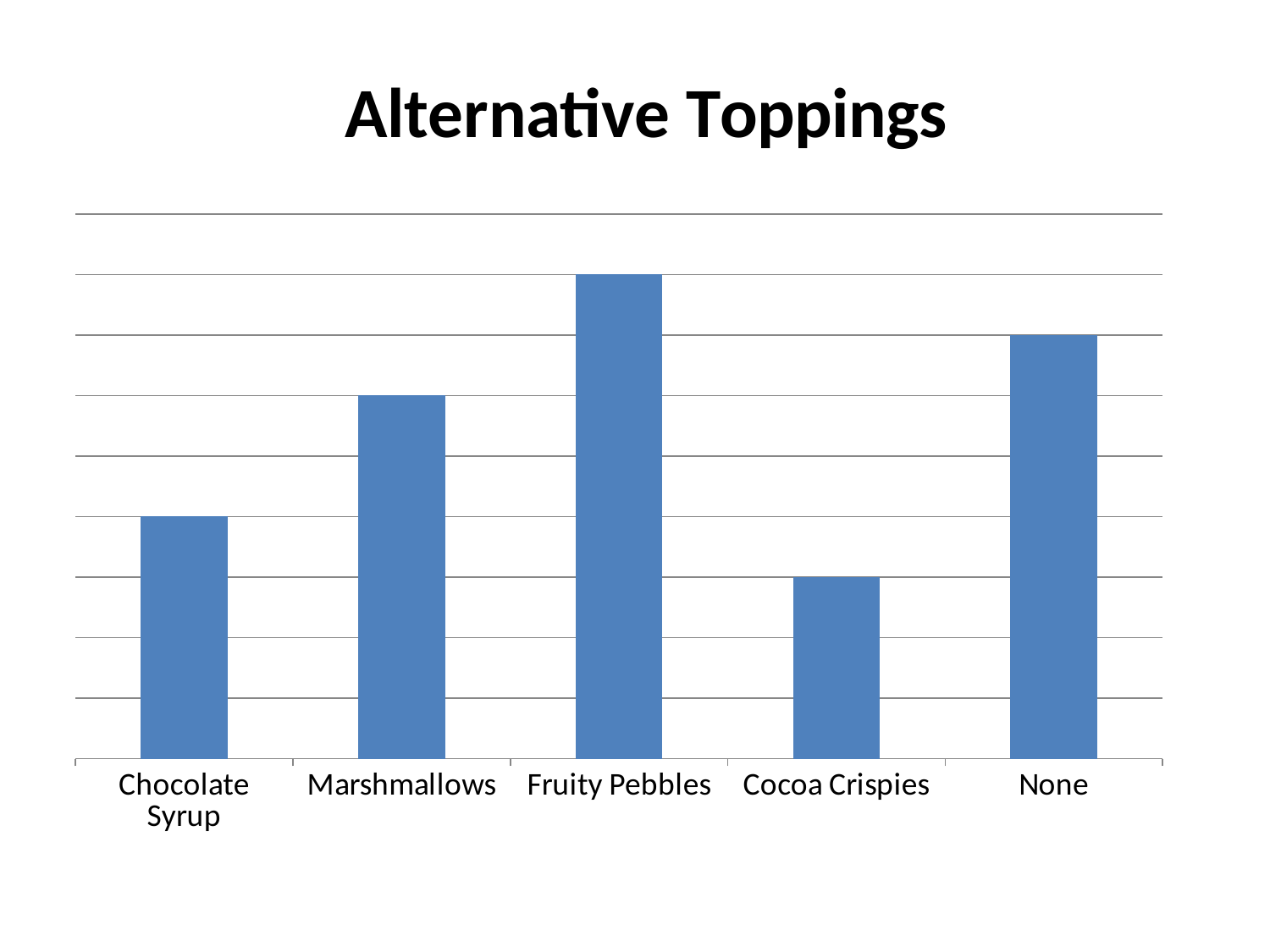
Which is larger, the value for Marshmallows or the value for Chocolate Syrup? Marshmallows Which category is listed first on the x axis? Chocolate Syrup How many categories are shown on the x axis of the chart? 5 What kind of chart is shown on the slide? bar chart Which category has the highest bar? Fruity Pebbles Which is larger, the value for Cocoa Crispies or the value for Chocolate Syrup? Chocolate Syrup Which category has the second-highest bar? None What colour are the bars in the chart? blue Which category has the lowest bar? Cocoa Crispies What is the title of the chart? Alternative Toppings Which is larger, the value for Fruity Pebbles or the value for None? Fruity Pebbles